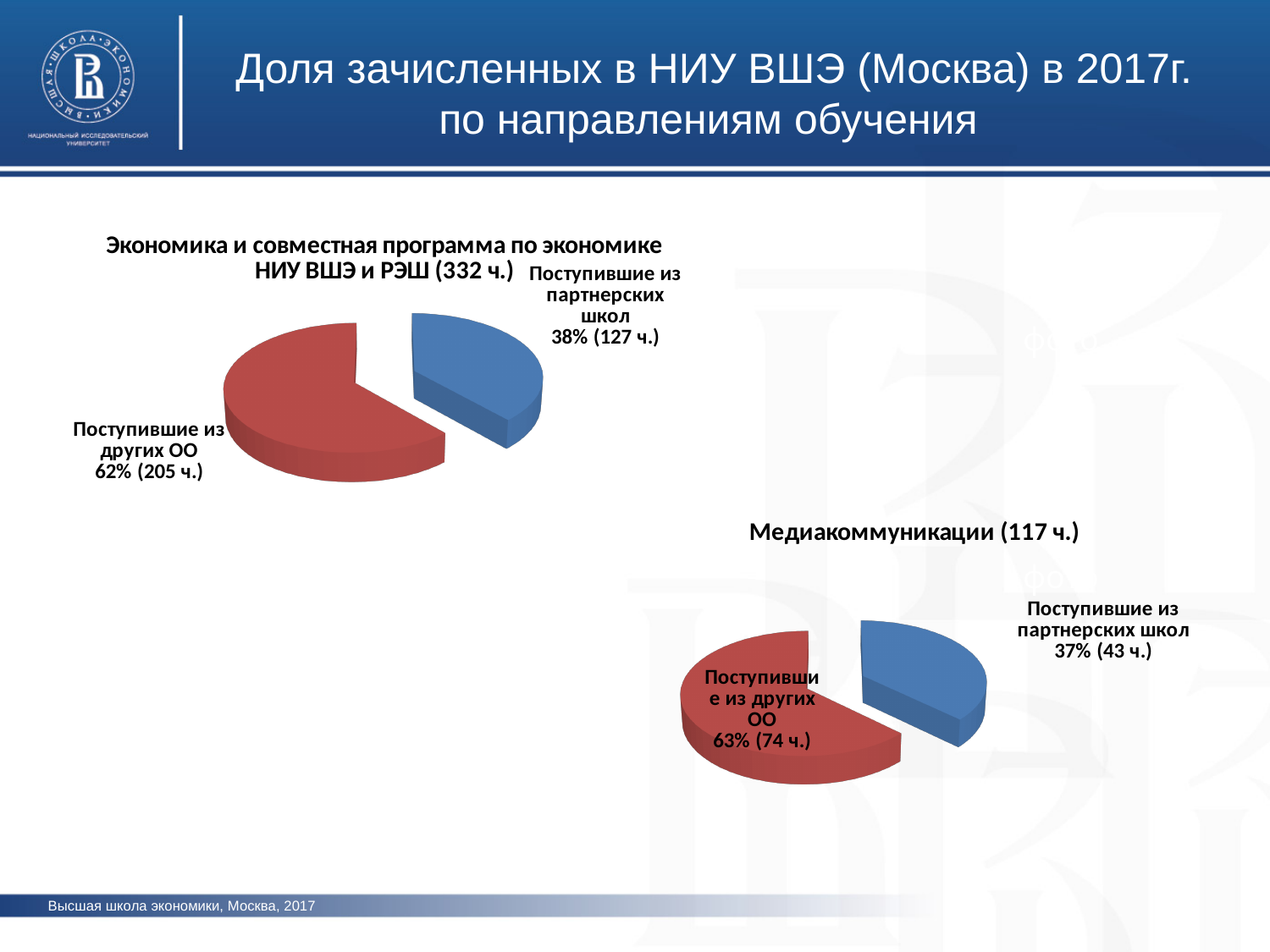
In the 'Медиакоммуникации (117 ч.)' chart, what share of enrolled students came from partner schools? 37% Which is larger: the number of students from partner schools in the 'Экономика и совместная программа по экономике НИУ ВШЭ и РЭШ (332 ч.)' chart or in the 'Медиакоммуникации (117 ч.)' chart? Экономика и совместная программа по экономике НИУ ВШЭ и РЭШ (127 ч.) What type of chart is used on this slide for the 'Экономика и совместная программа по экономике НИУ ВШЭ и РЭШ (332 ч.)' data? Pie chart How many slices does the 'Медиакоммуникации (117 ч.)' pie chart have? 2 In the 'Экономика и совместная программа по экономике НИУ ВШЭ и РЭШ (332 ч.)' chart, which slice is the largest? Поступившие из других ОО In the 'Экономика и совместная программа по экономике НИУ ВШЭ и РЭШ (332 ч.)' chart, what is the difference in student numbers between those from other educational organisations and those from partner schools? 78 ч. In the 'Экономика и совместная программа по экономике НИУ ВШЭ и РЭШ (332 ч.)' chart, how many students came from other educational organisations (Поступившие из других ОО)? 205 ч. In the 'Экономика и совместная программа по экономике НИУ ВШЭ и РЭШ (332 ч.)' chart, how many students came from partner schools? 127 ч. In the 'Медиакоммуникации (117 ч.)' chart, how many students came from partner schools? 43 ч. In the 'Медиакоммуникации (117 ч.)' chart, how many students came from other educational organisations (Поступившие из других ОО)? 74 ч. In the 'Медиакоммуникации (117 ч.)' chart, which slice is the smallest? Поступившие из партнерских школ In the 'Экономика и совместная программа по экономике НИУ ВШЭ и РЭШ (332 ч.)' chart, what share of enrolled students came from partner schools (Поступившие из партнерских школ)? 38%